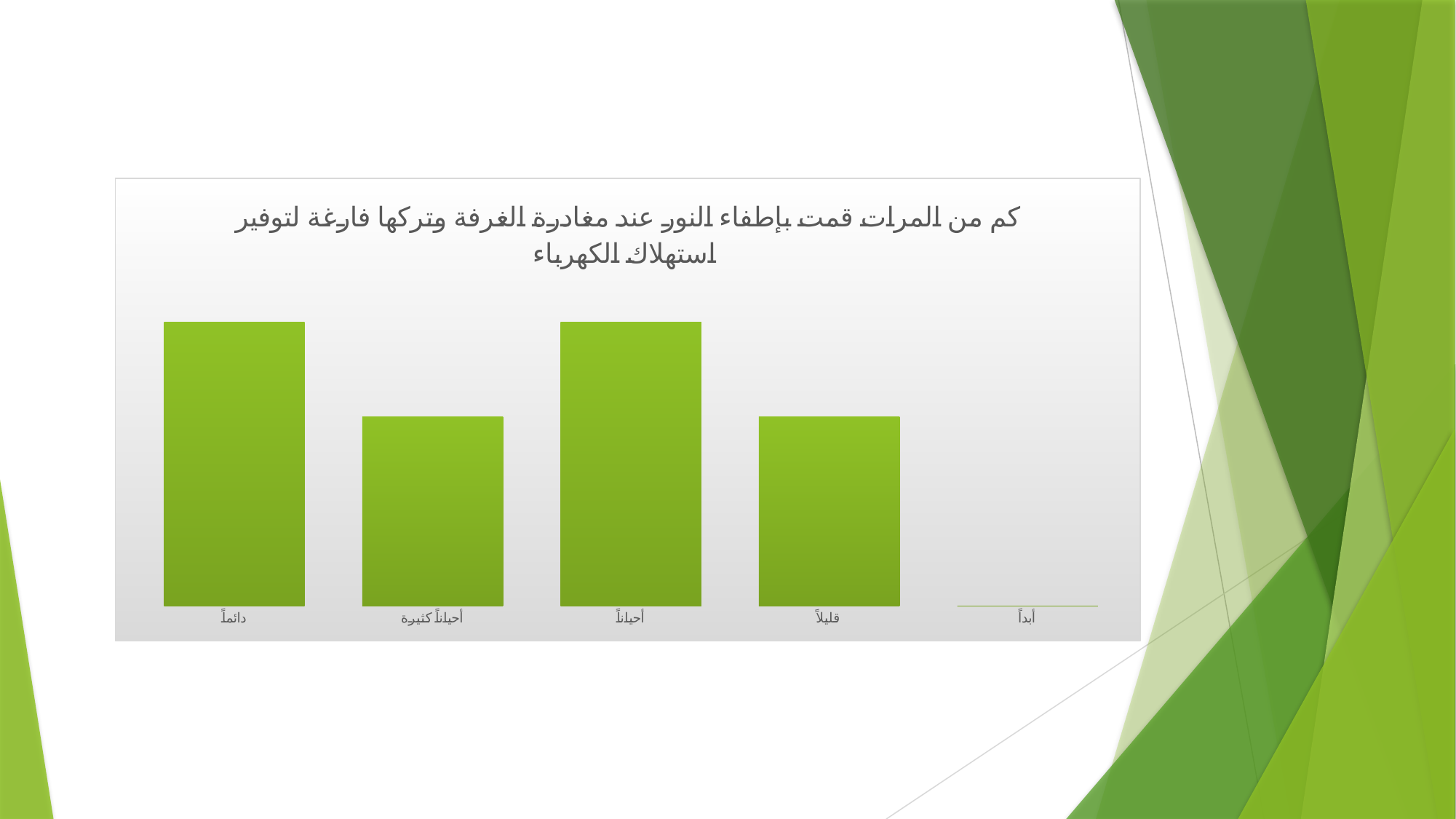
Which is larger, the value for أحياناً or the value for قليلاً? أحياناً What kind of chart is shown on the slide? bar chart How many categories are shown on the x axis of the chart? 5 Which is larger, the value for دائماً or the value for أحياناً كثيرة? دائماً Which is larger, the value for أحياناً or the value for أحياناً كثيرة? أحياناً Which category has the lowest value in the chart? أبداً What is the title of the chart? كم من المرات قمت بإطفاء النور عند مغادرة الغرفة وتركها فارغة لتوفير استهلاك الكهرباء What colour are the bars in the chart? green